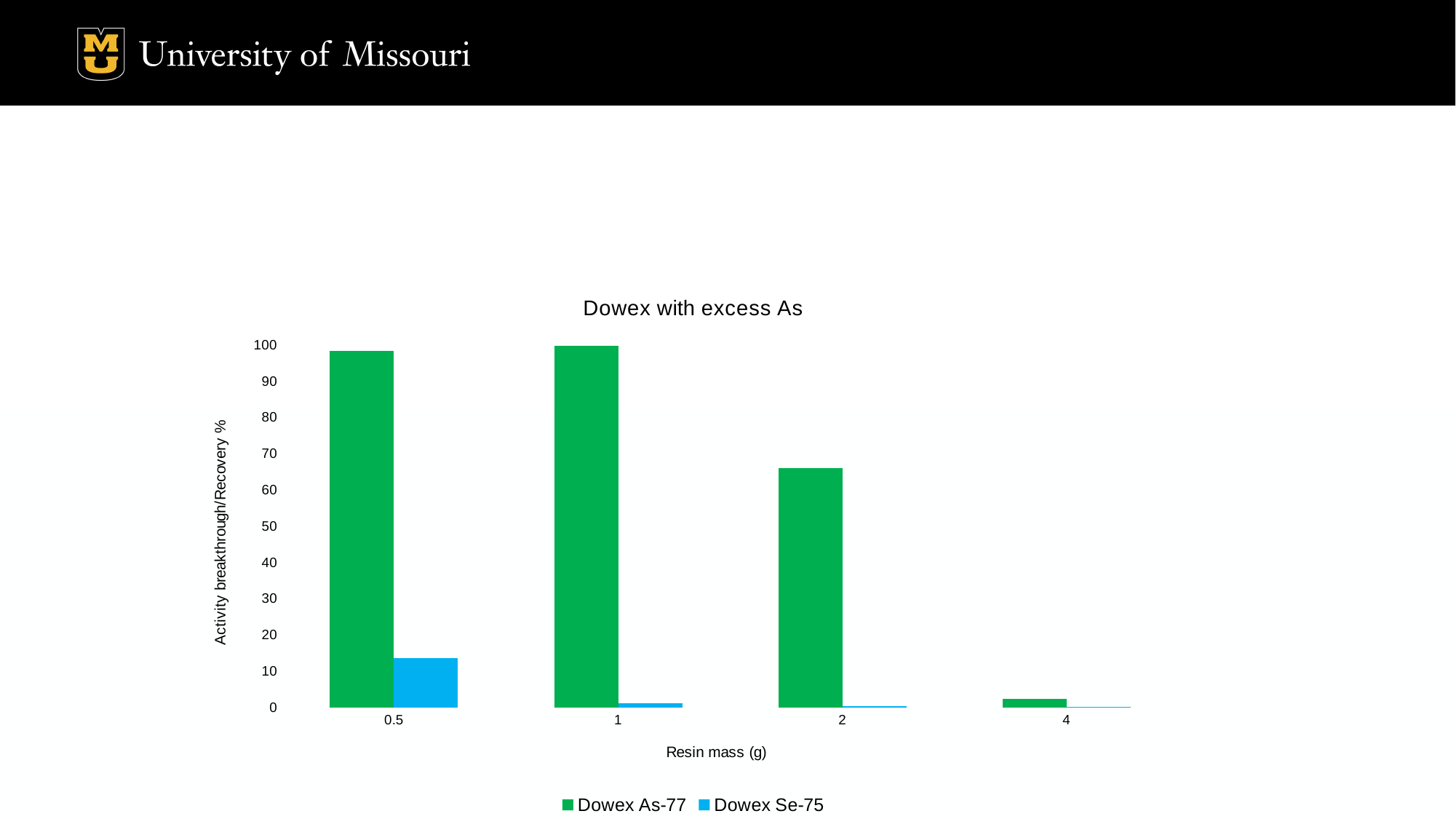
What kind of chart is shown on the slide? bar chart What is the title of the chart? Dowex with excess As Is the Dowex As-77 value at resin mass 2 greater or less than 50? greater Is the Dowex Se-75 value at resin mass 0.5 greater or less than 20? less At which resin mass is the Dowex As-77 value lowest? 4 At which resin mass is the Dowex Se-75 value highest? 0.5 What is the label of the x axis? Resin mass (g) Is the Dowex As-77 value at resin mass 4 greater or less than 10? less At resin mass 0.5, which series has the larger value, Dowex As-77 or Dowex Se-75? Dowex As-77 How many series does the legend list? 2 Do the Dowex Se-75 values rise or fall as resin mass increases along the x axis? fall How many resin mass categories are shown on the x axis? 4